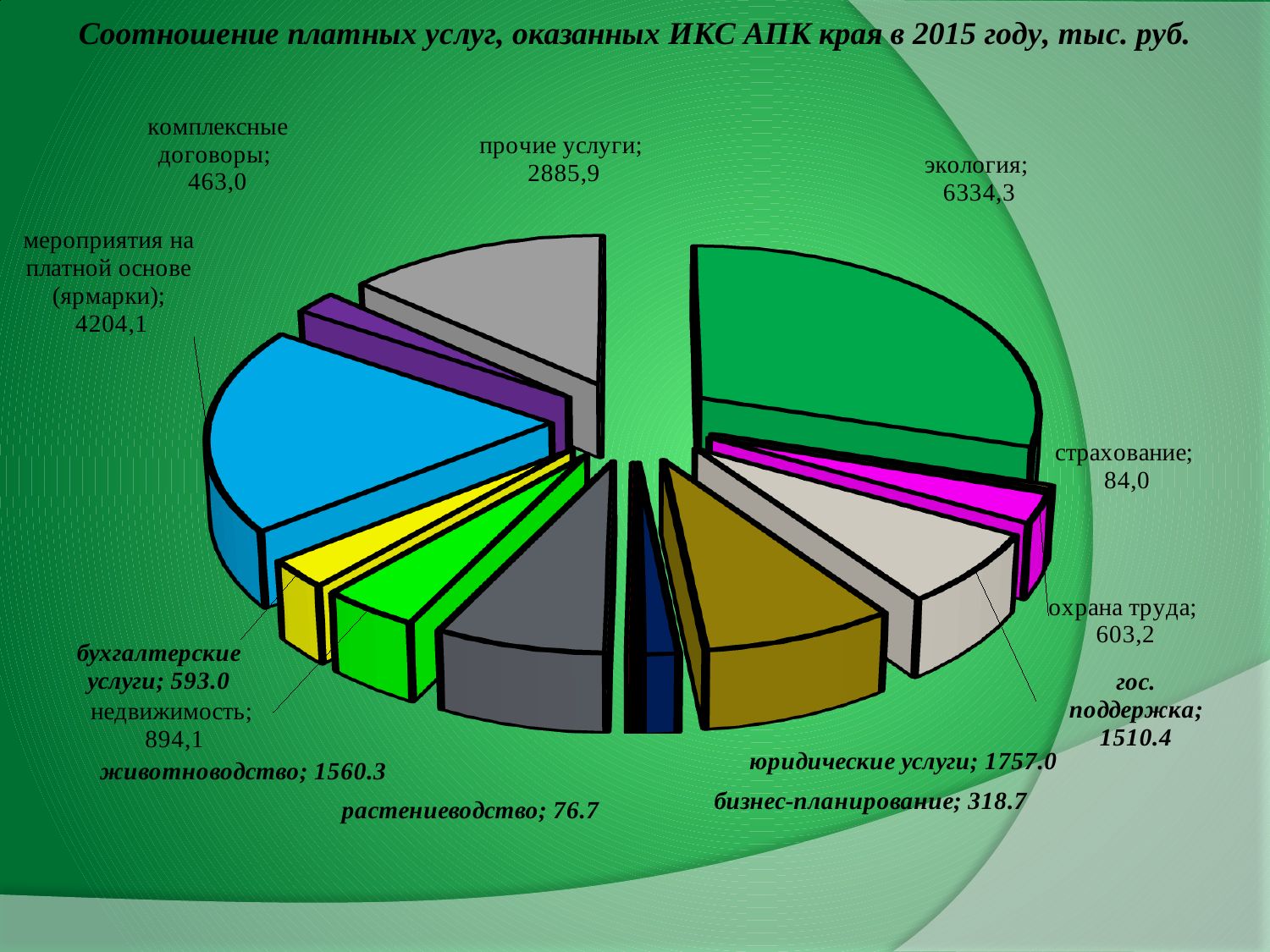
What kind of chart is shown on the slide? pie chart What is the title of the chart? Соотношение платных услуг, оказанных ИКС АПК края в 2015 году, тыс. руб. Which is larger, прочие услуги or мероприятия на платной основе (ярмарки)? мероприятия на платной основе (ярмарки) What is the value for юридические услуги? 1757.0 What is the difference between the values for юридические услуги and гос. поддержка? 246.6 Which category has the smallest value? растениеводство What is the value for мероприятия на платной основе (ярмарки)? 4204,1 What is the difference between the values for экология and мероприятия на платной основе (ярмарки)? 2130,2 Which category has the largest value? экология What is the value for экология? 6334,3 How many categories does the pie chart show? 13 What is the value for страхование? 84,0